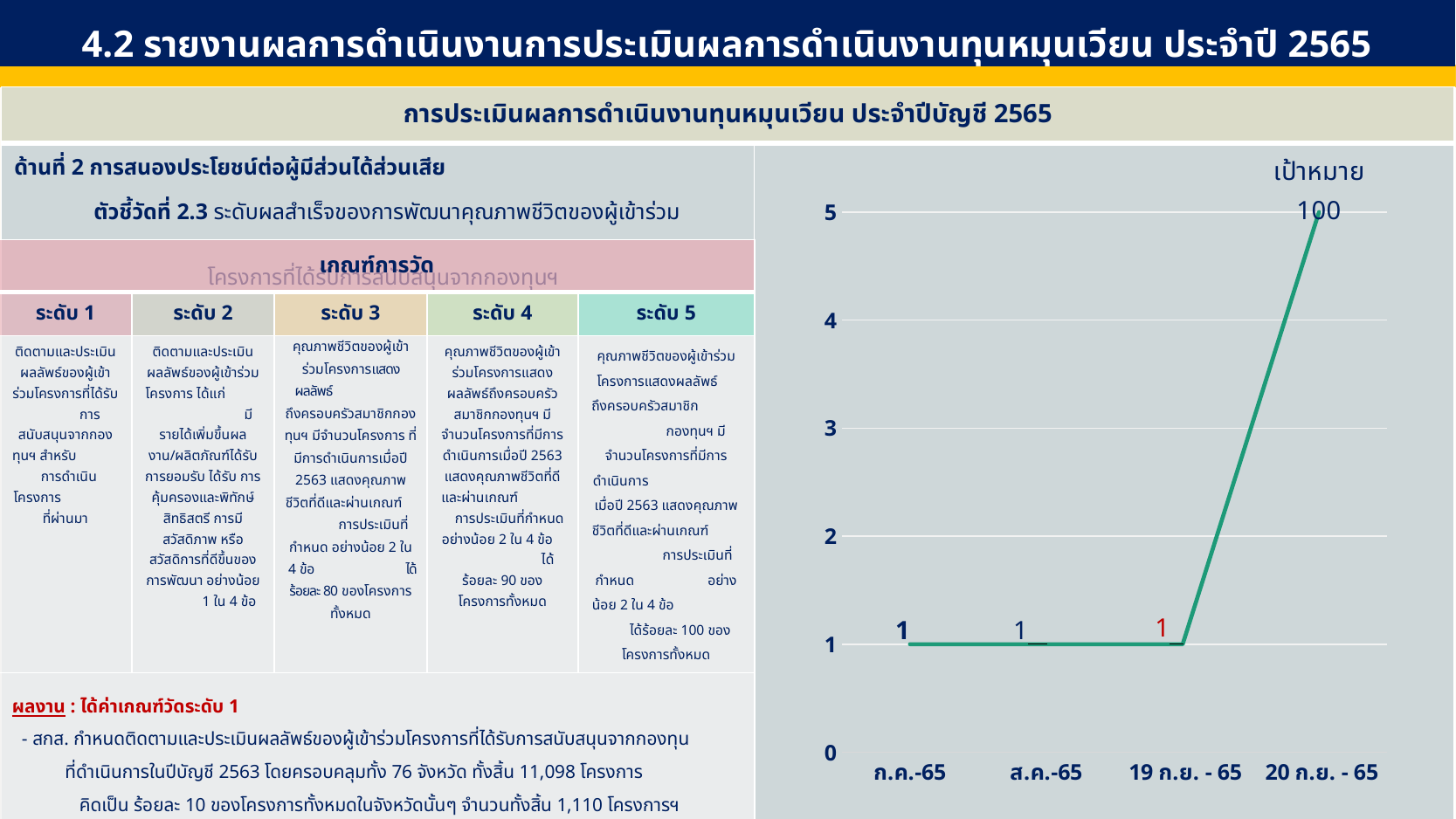
What word is printed above the last data point of the line chart? เป้าหมาย How many data points are plotted on the line chart? 4 What is the value shown for ก.ค.-65 on the line chart? 1 Is the value for ส.ค.-65 on the line chart greater or less than 2? less Which category on the line chart has the highest value? 20 ก.ย. - 65 Is the value for 20 ก.ย. - 65 on the line chart greater or less than 4? greater What is the value shown for 19 ก.ย. - 65 on the line chart? 1 Do the values on the line chart rise or fall from 19 ก.ย. - 65 to 20 ก.ย. - 65? rise Which is larger on the line chart, the value for ก.ค.-65 or the value for 20 ก.ย. - 65? 20 ก.ย. - 65 What is the highest tick value shown on the y-axis of the line chart? 5 What kind of chart is shown on the right side of the slide? line chart What is the value shown for ส.ค.-65 on the line chart? 1